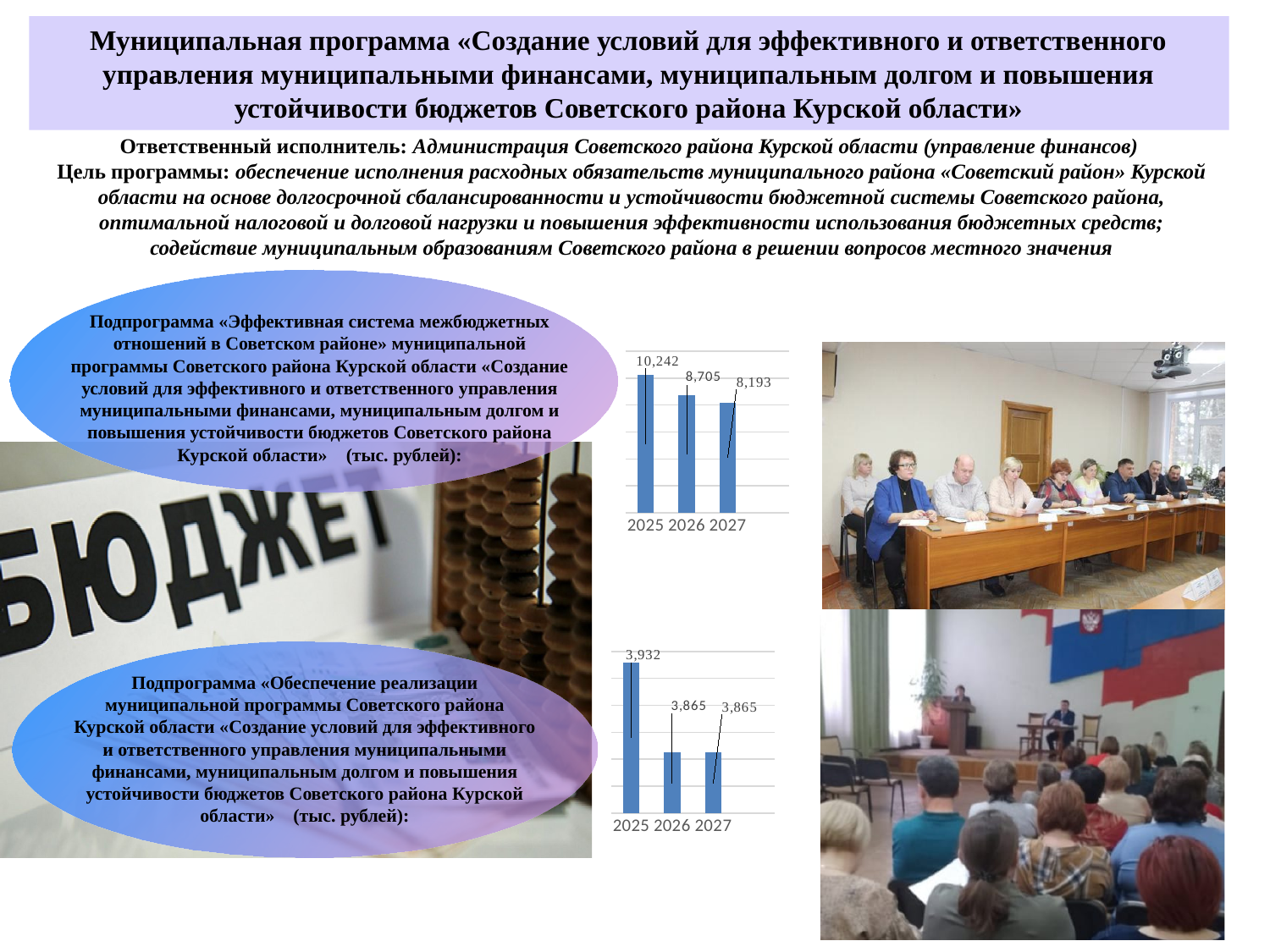
In the upper chart in the middle of the slide, what is the value for 2025? 10,242 In the upper chart in the middle of the slide, what is the value for 2027? 8,193 In the upper chart in the middle of the slide, what is the difference between the values for 2025 and 2026? 1,537 In the lower chart in the middle of the slide, what is the value for 2025? 3,932 What kind of chart is the upper chart in the middle of the slide? bar chart In the lower chart in the middle of the slide, which year has the highest value? 2025 In the upper chart in the middle of the slide, do the values rise or fall from 2025 to 2027? fall In the upper chart in the middle of the slide, which year has the lowest value? 2027 How many years are shown on the x axis of the lower chart in the middle of the slide? 3 In the lower chart in the middle of the slide, what is the value for 2026? 3,865 In the upper chart in the middle of the slide, which year has the highest value? 2025 In the lower chart in the middle of the slide, what is the difference between the values for 2025 and 2027? 67